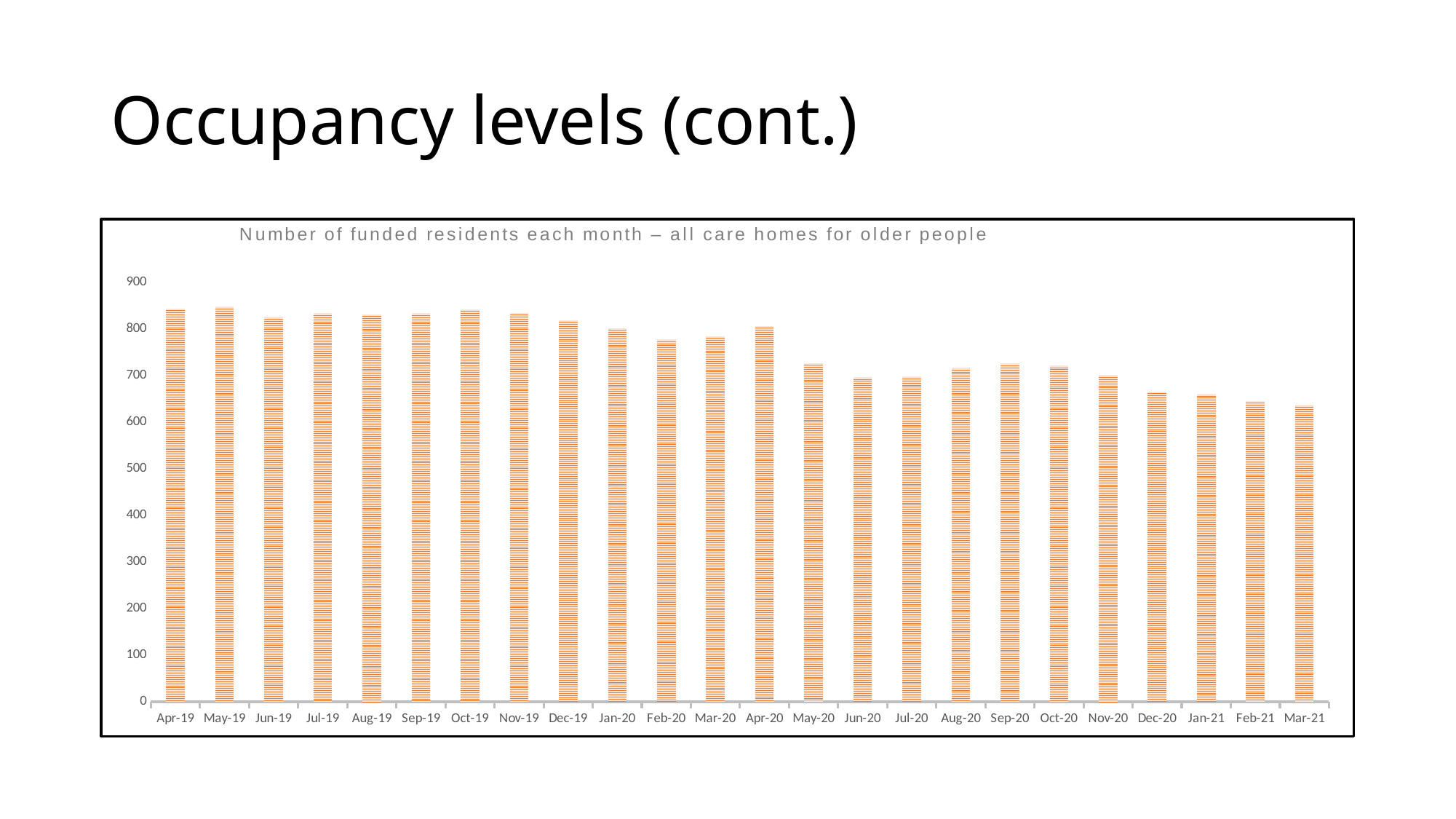
What kind of chart is shown on the slide? bar chart Which is larger, the value for Apr-19 or the value for Mar-21? Apr-19 Do the values generally rise or fall from Apr-19 to Mar-21? fall Is the value for Mar-21 greater or less than 600? greater What colour are the bars in the chart? orange How many months are plotted on the x axis? 24 What is the title of the chart? Number of funded residents each month – all care homes for older people Which is larger, the value for Apr-20 or the value for May-20? Apr-20 Is the value for Feb-20 greater or less than 800? less Which month has the lowest number of funded residents? Mar-21 Is the value for Apr-19 greater or less than 800? greater